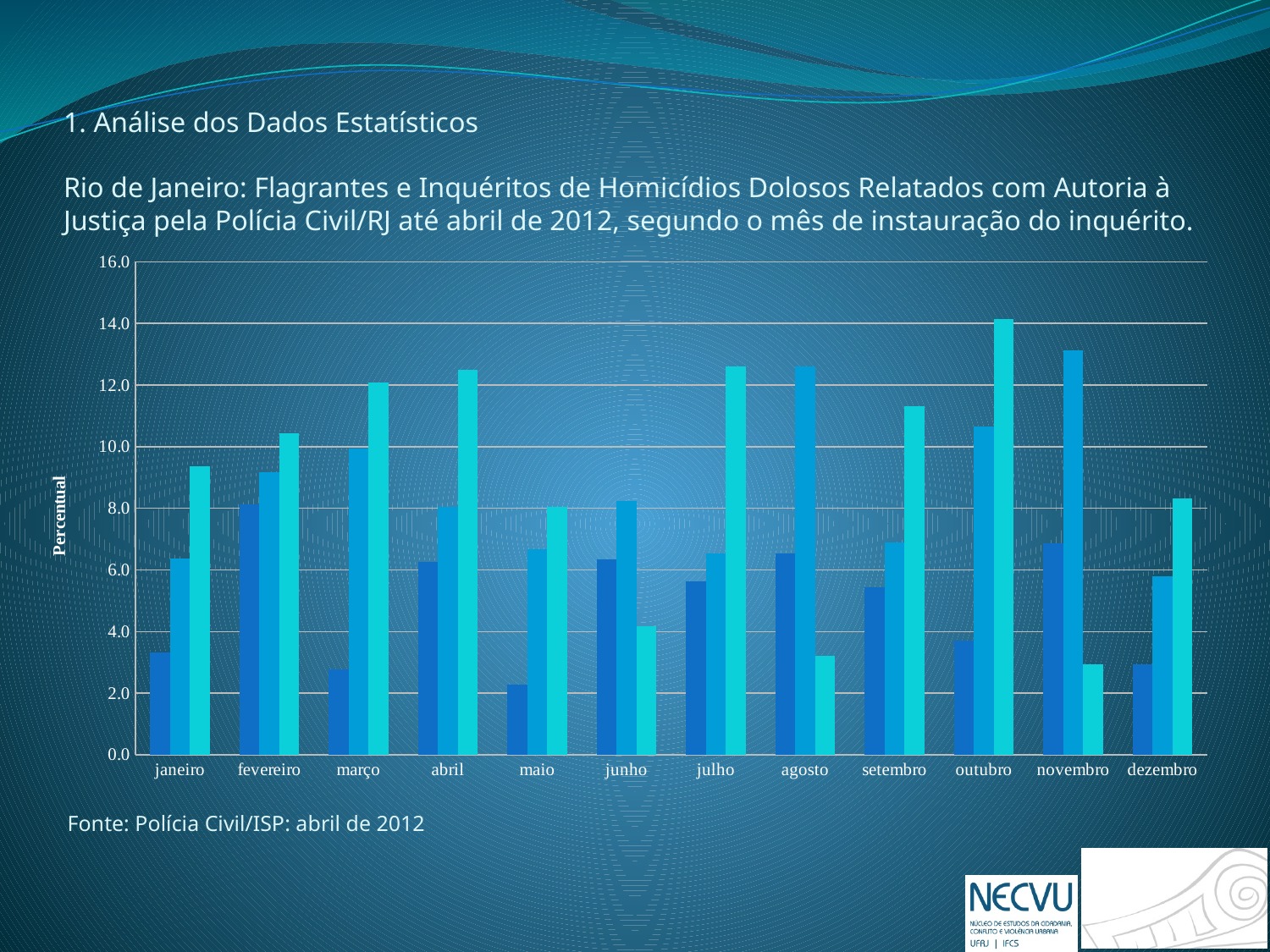
Is the value of the lightest (cyan) bar for outubro greater or less than 12.0? greater Is the value of the lightest (cyan) bar for junho greater or less than 6.0? less What kind of chart is shown on the slide? bar chart What is the label of the vertical axis of the chart? Percentual How many months are shown along the x axis of the chart? 12 Among the lightest (cyan) bars, which month has the lowest value? novembro Among the darkest blue bars, which month has the highest value? fevereiro For janeiro, which is larger: the darkest blue bar or the lightest (cyan) bar? the lightest (cyan) bar Is the value of the darkest blue bar for maio greater or less than 4.0? less How many bars are plotted for each month in the chart? 3 Among the lightest (cyan) bars, which month has the highest value? outubro What source is cited below the chart? Fonte: Polícia Civil/ISP: abril de 2012